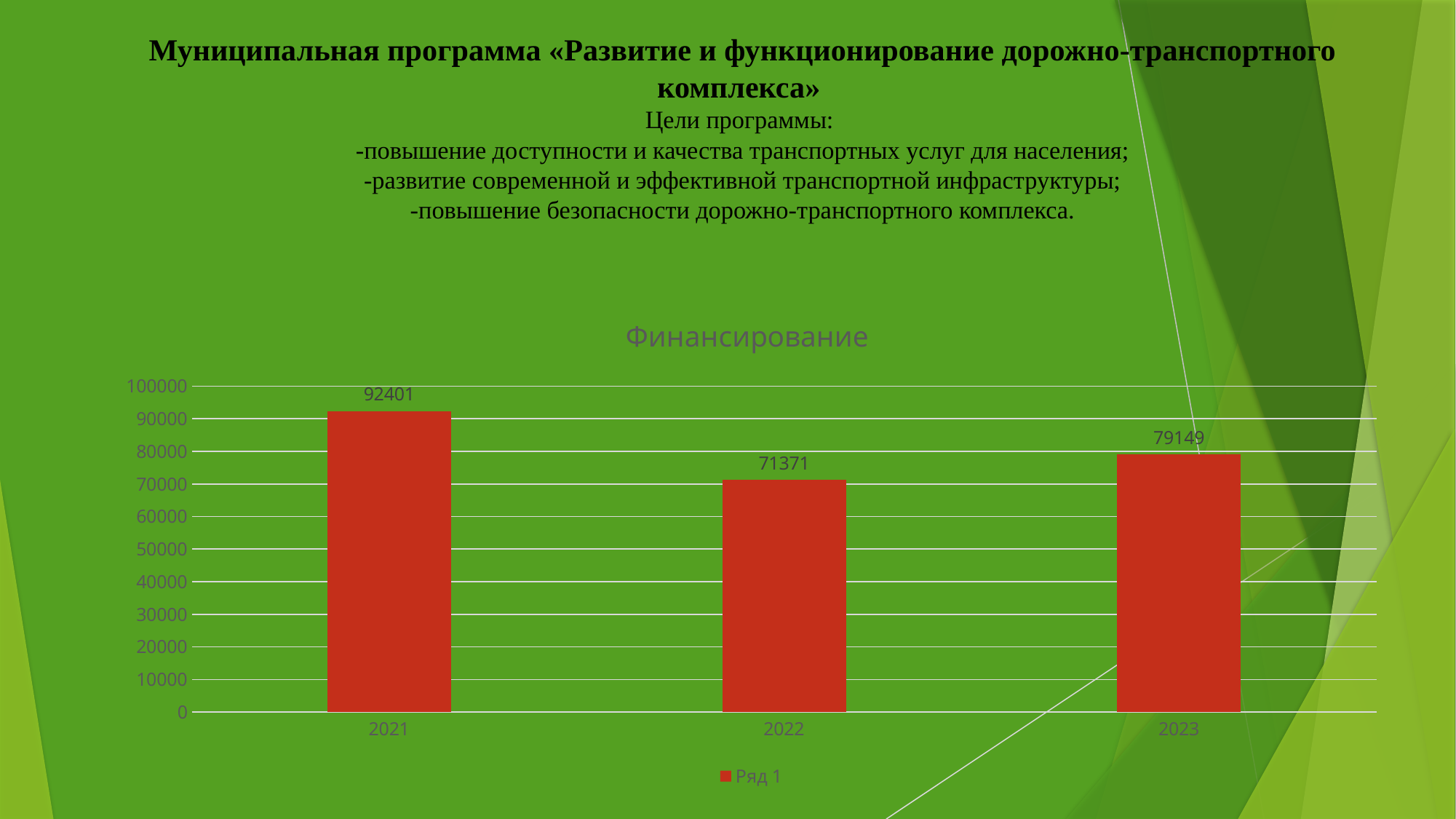
What is the difference between the values for 2021 and 2022? 21030 How many years are shown on the x axis of the chart? 3 Which year has the lowest value in the Финансирование chart? 2022 What is the difference between the values for 2023 and 2022? 7778 What is the value for 2023 in the Финансирование chart? 79149 Which is larger, the value for 2022 or the value for 2023? 2023 What is the title of the chart? Финансирование What is the value for 2022 in the Финансирование chart? 71371 What is the value for 2021 in the Финансирование chart? 92401 What kind of chart is shown on the slide? bar chart Is the value for 2021 greater or less than 90000? greater Which year has the highest value in the Финансирование chart? 2021